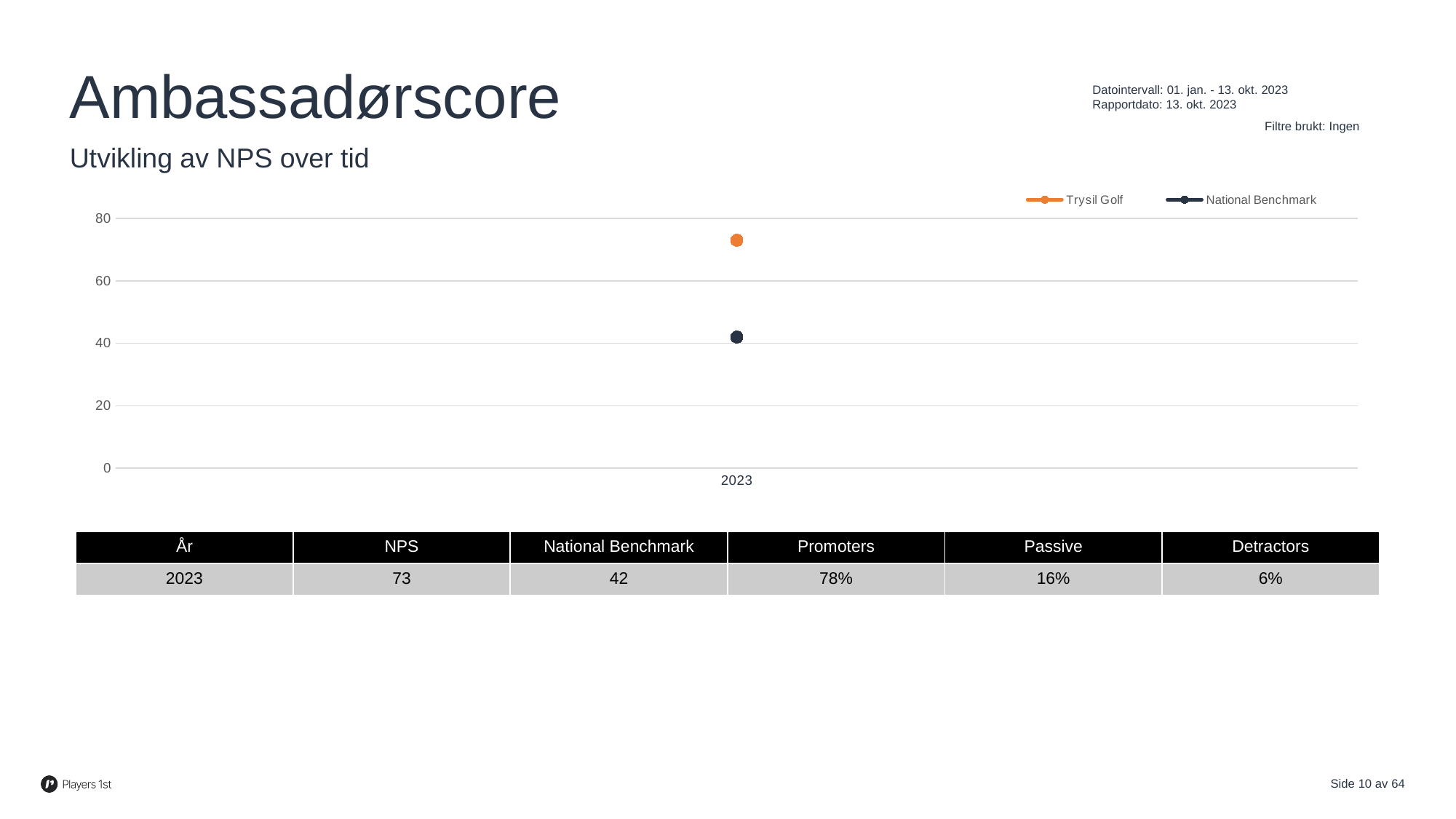
What is the value for Trysil Golf in 2023? 73 Is the value for Trysil Golf in 2023 greater or less than 60? greater What is the highest value shown on the y axis? 80 How many years are shown on the x axis? 1 What is the value for National Benchmark in 2023? 42 Is the value for National Benchmark in 2023 greater or less than 60? less What kind of chart is shown? line chart How many series does the legend list? 2 What is the title of the chart? Utvikling av NPS over tid Which series has the higher value in 2023, Trysil Golf or National Benchmark? Trysil Golf What is the difference between the Trysil Golf value and the National Benchmark value in 2023? 31 Which series is shown in orange? Trysil Golf